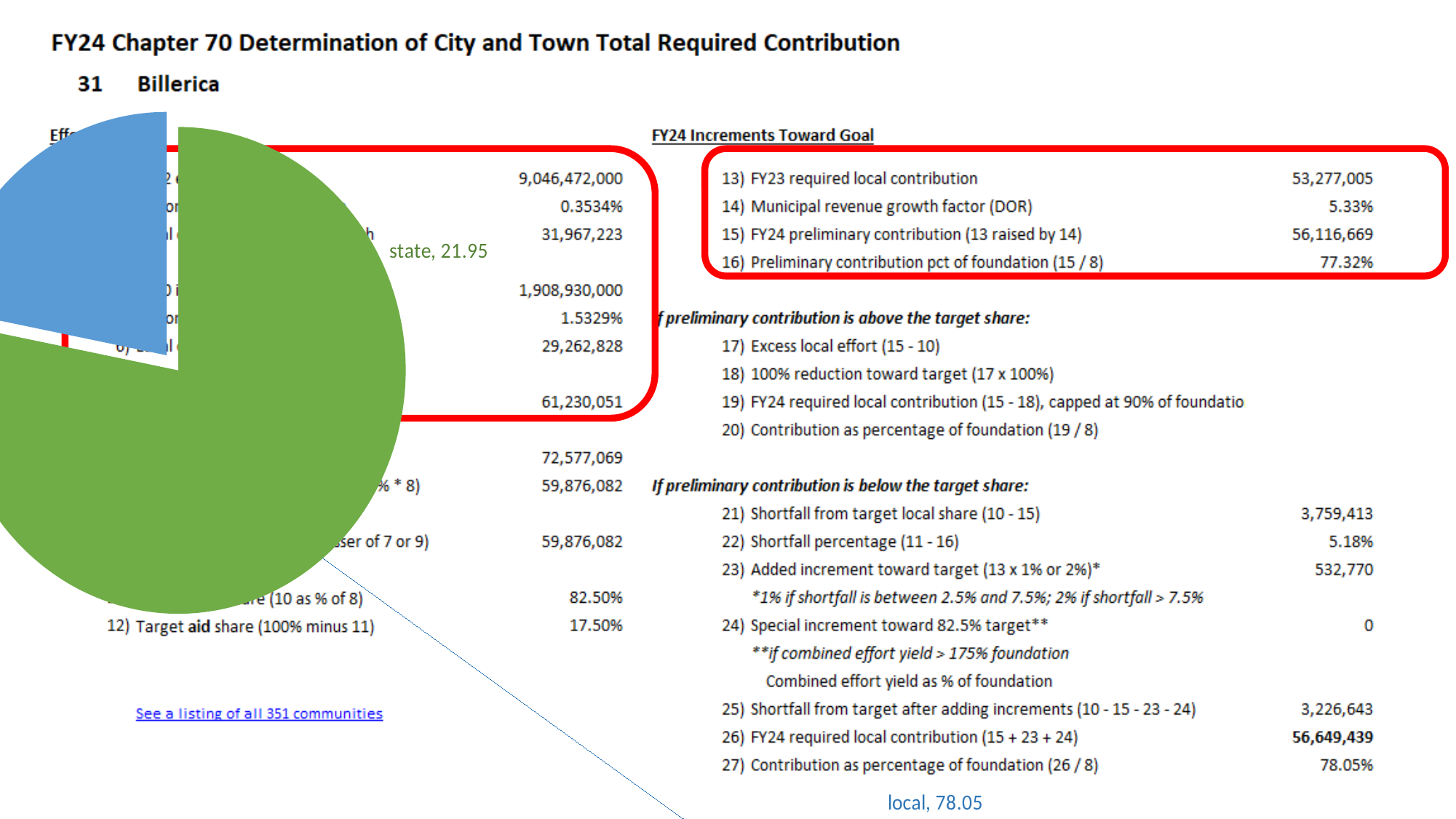
What is the value shown for the local slice of the pie chart? 78.05 What kind of chart is shown on the slide? pie chart How many slices does the pie chart have? 2 What do the two slice values in the pie chart add up to? 100 Which slice of the pie chart is the smallest? state Which slice of the pie chart is the largest? local Which is larger in the pie chart, the local slice or the state slice? local Is the value for the local slice greater or less than 50? greater What is the value shown for the state slice of the pie chart? 21.95 What is the difference between the local value and the state value in the pie chart? 56.10 Is the value for the state slice greater or less than 25? less What are the two category labels shown on the pie chart? state and local